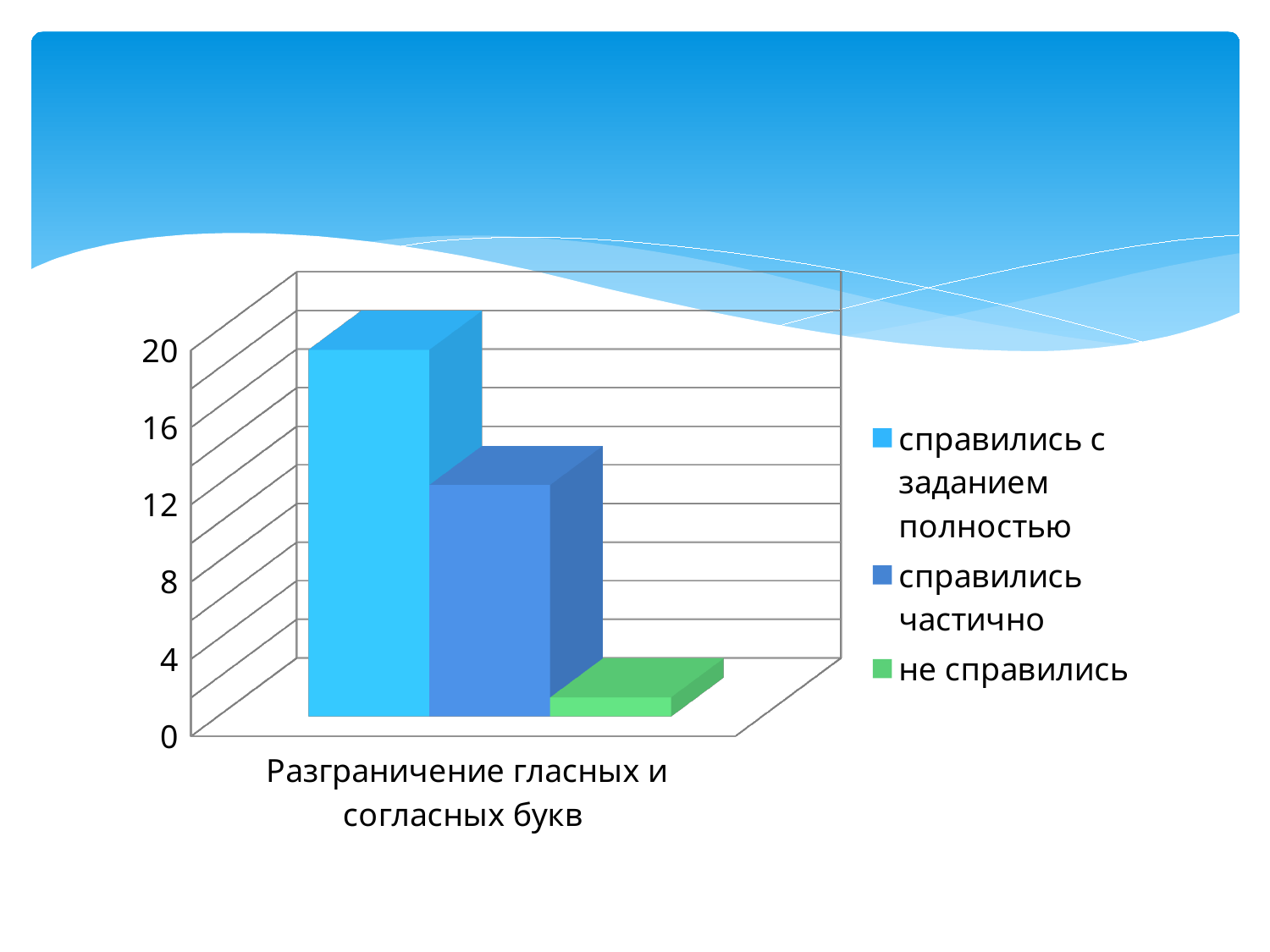
Is the value for "справились с заданием полностью" greater or less than 16? greater What colour is the bar for "не справились"? green Which is larger, the value for "справились частично" or the value for "не справились"? справились частично How many categories are shown on the x axis? 1 How many series does the legend list? 3 What kind of chart is shown on the slide? bar chart What is the category label on the x axis? Разграничение гласных и согласных букв Is the value for "не справились" greater or less than 4? less Is the value for "справились частично" greater or less than 16? less Which series has the highest value? справились с заданием полностью Which series has the lowest value? не справились Which is larger, the value for "справились с заданием полностью" or the value for "справились частично"? справились с заданием полностью